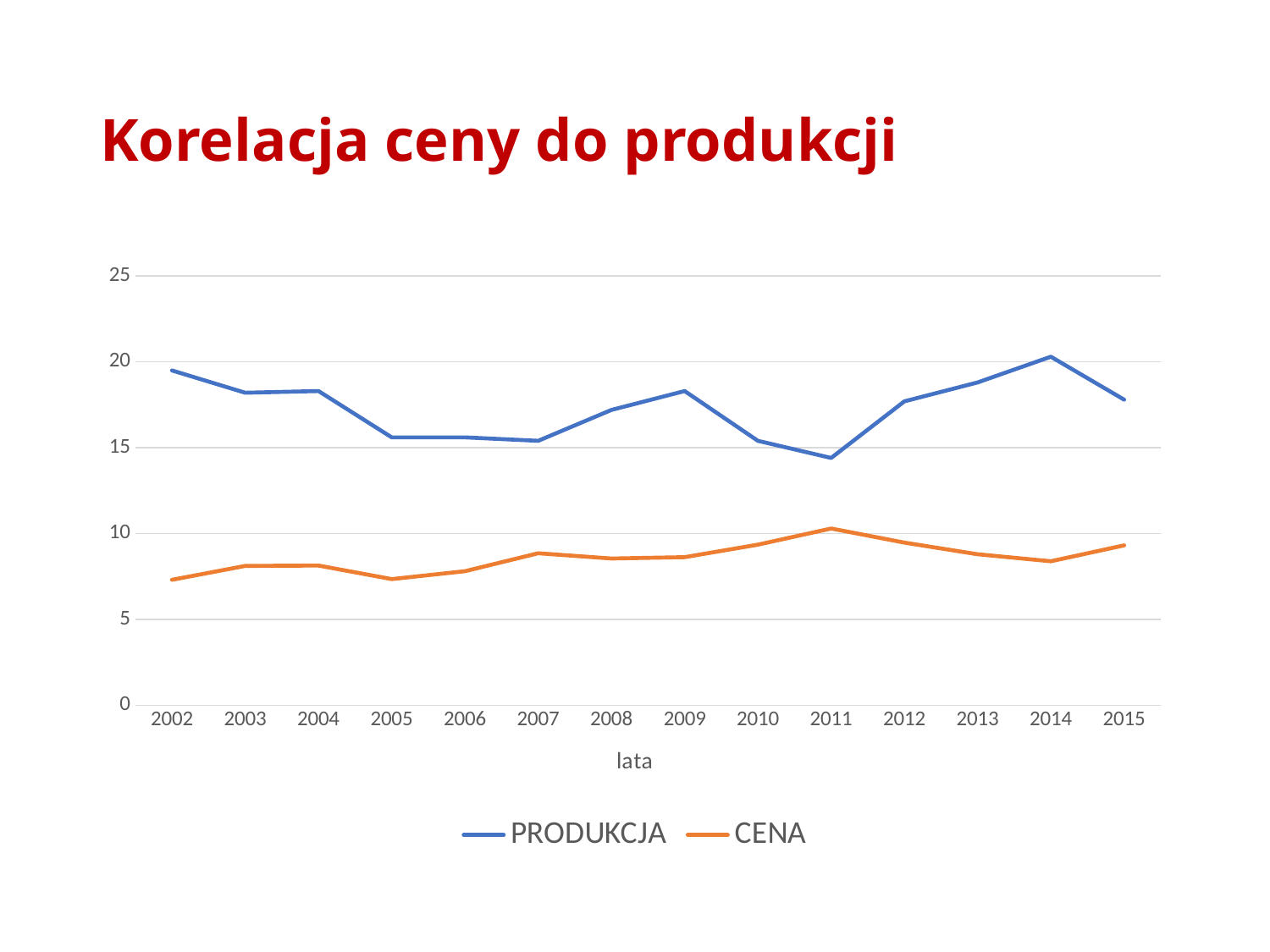
How many years are shown on the x axis? 14 What kind of chart is shown on the slide? line chart What is the title of the x axis? lata In which year is PRODUKCJA lowest? 2011 Which is larger, PRODUKCJA in 2002 or PRODUKCJA in 2011? PRODUKCJA in 2002 How many series does the legend list? 2 Is the value for PRODUKCJA in 2014 greater or less than 20? greater Is the value for PRODUKCJA in 2011 greater or less than 15? less In which year is CENA highest? 2011 In which year is PRODUKCJA highest? 2014 Is the value for CENA in 2011 greater or less than 10? greater Does PRODUKCJA rise or fall from 2011 to 2014? rise